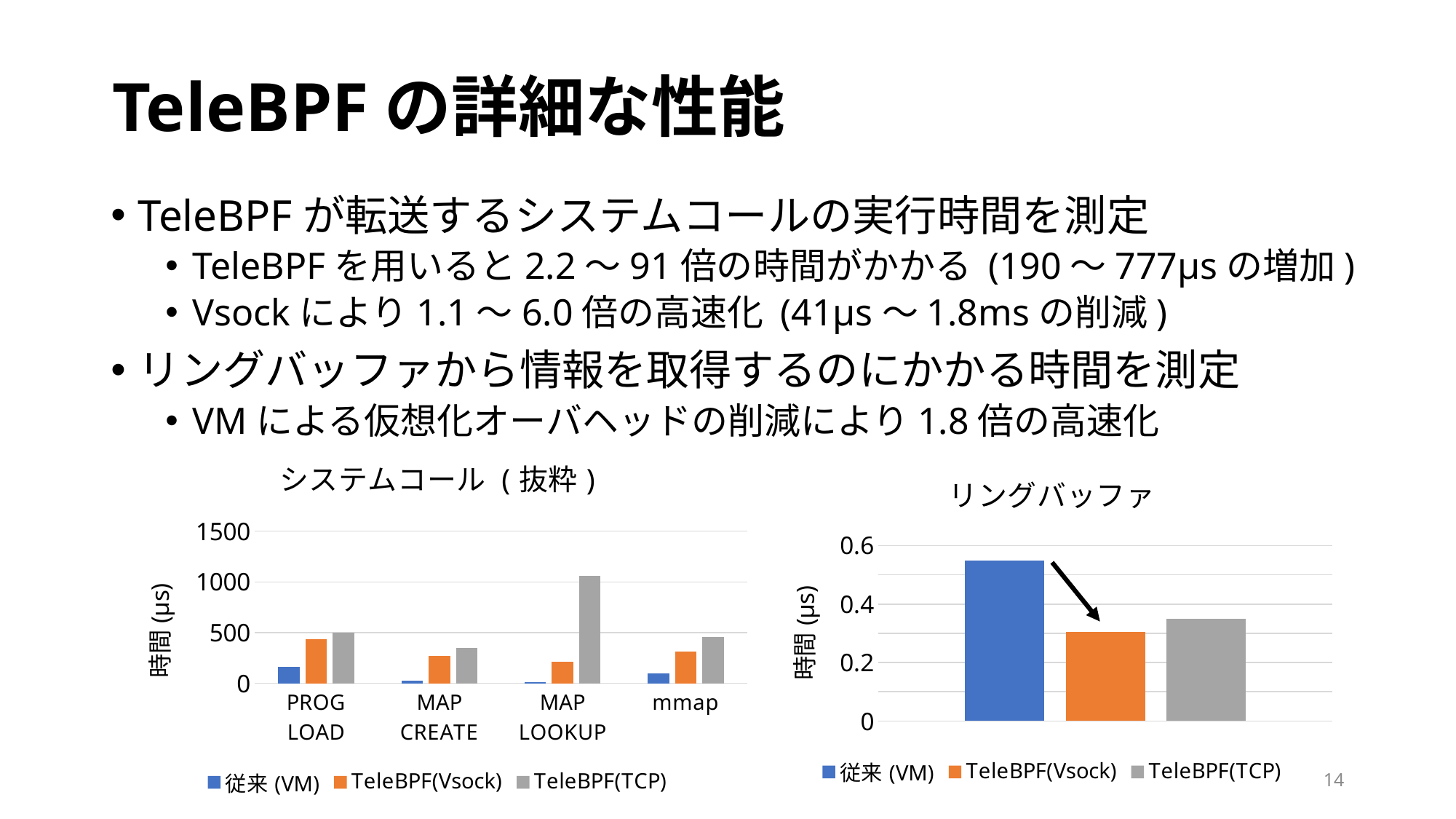
What is the y-axis label of the リングバッファ chart? 時間 (µs) How many categories are shown on the x axis of the システムコール（抜粋） chart? 4 How many series does the legend of the システムコール（抜粋） chart list? 3 What kind of chart is the リングバッファ chart on the right? bar chart In the システムコール（抜粋） chart, which series has the lowest bar for mmap? 従来 (VM) In the システムコール（抜粋） chart, is the TeleBPF(TCP) value for MAP LOOKUP greater or less than 1000? greater In the リングバッファ chart, is the 従来 (VM) value greater or less than 0.4? greater In the リングバッファ chart, which series has the highest bar? 従来 (VM) In the システムコール（抜粋） chart, is the 従来 (VM) value for PROG LOAD greater or less than 500? less What kind of chart is the システムコール（抜粋） chart on the left? bar chart In the システムコール（抜粋） chart, for which category is the TeleBPF(TCP) bar highest? MAP LOOKUP In the システムコール（抜粋） chart, for MAP CREATE, which is larger: TeleBPF(Vsock) or TeleBPF(TCP)? TeleBPF(TCP)